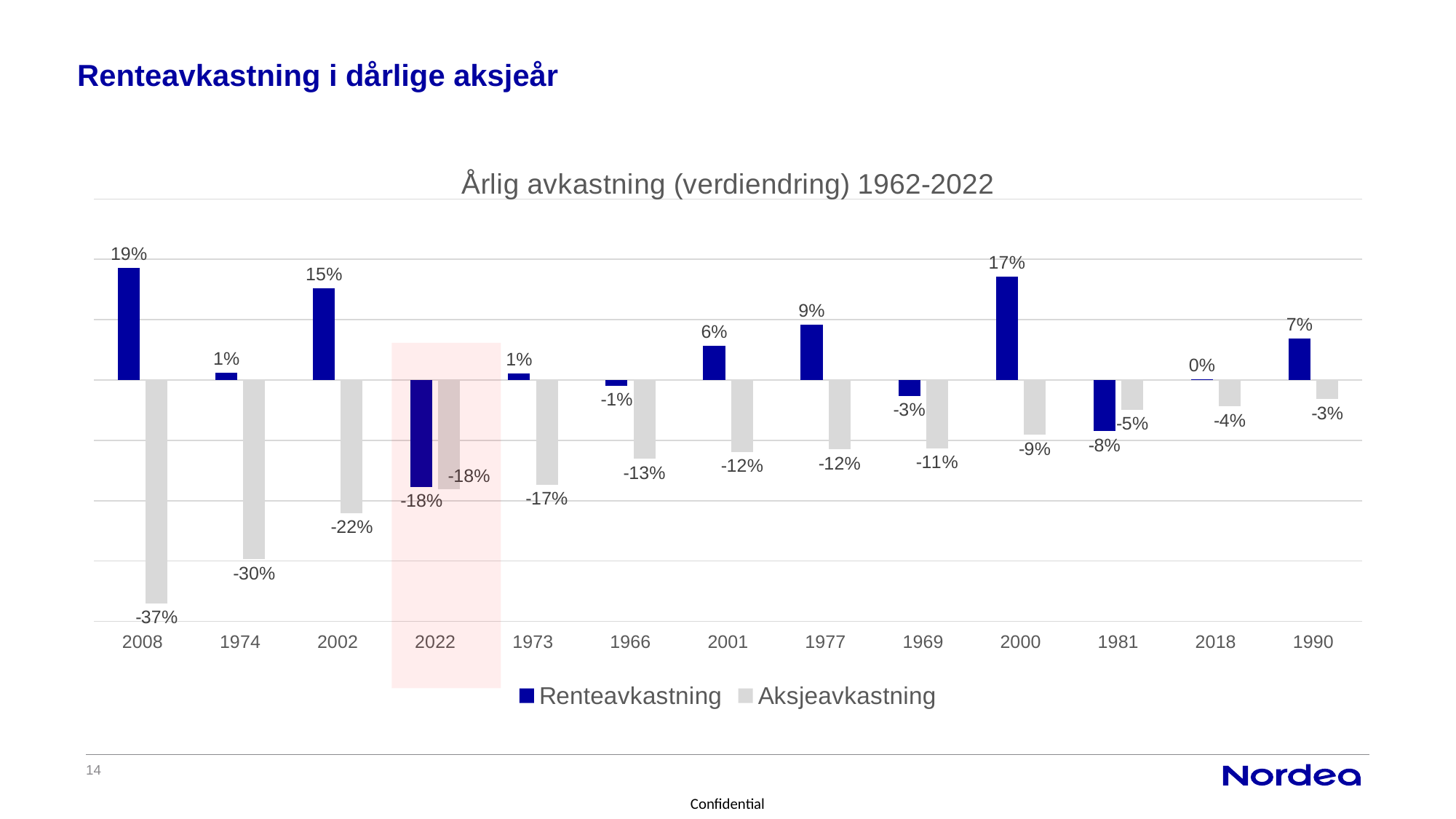
What kind of chart is shown on the slide? Bar chart Which is larger, the Renteavkastning value for 2000 or for 1977? 2000 Do the Aksjeavkastning values rise or fall from left to right along the x axis? Rise Which year has the highest Renteavkastning value? 2008 What is the Renteavkastning value for 2022? -18% What is the Aksjeavkastning value for 1974? -30% What is the Renteavkastning value for 2008? 19% What is the difference between the Renteavkastning and Aksjeavkastning values for 2002? 37 percentage points How many years are shown on the x axis? 13 What is the title of the chart? Årlig avkastning (verdiendring) 1962-2022 Which year has the lowest Aksjeavkastning value? 2008 How many series does the legend list? 2